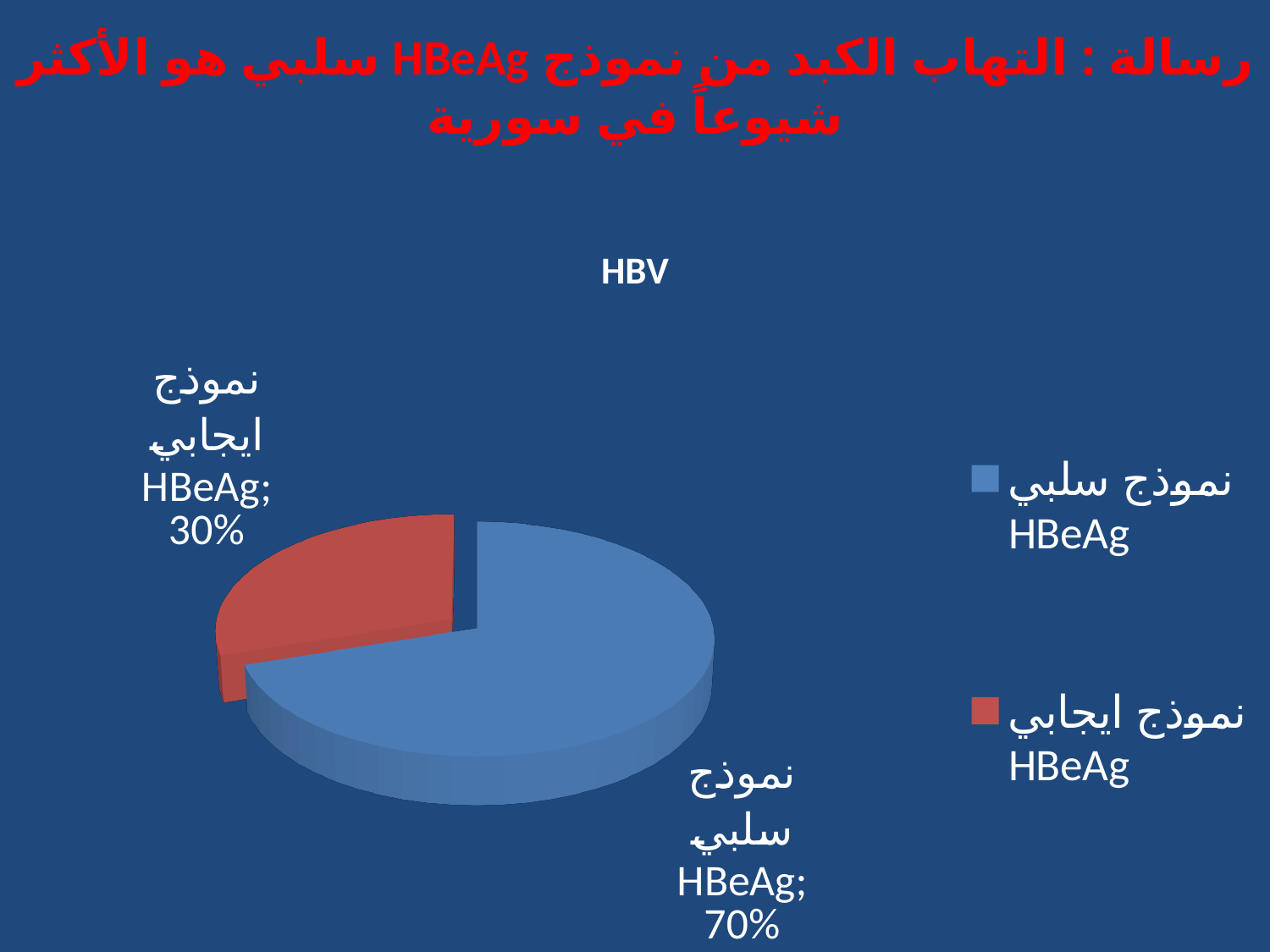
What colour is the slice for نموذج ايجابي HBeAg? red Which slice of the pie is the smallest? نموذج ايجابي HBeAg What is the title of the chart? HBV Which slice of the pie is the largest? نموذج سلبي HBeAg How many entries does the legend list? 2 What share of the pie does the HBeAg negative pattern take? 70% Which is larger, the HBeAg negative slice or the HBeAg positive slice? نموذج سلبي HBeAg What percentage is shown for the HBeAg negative pattern (نموذج سلبي HBeAg)? 70% What kind of chart is shown on the slide? pie chart What percentage is shown for the HBeAg positive pattern (نموذج ايجابي HBeAg)? 30% How many slices does the pie chart have? 2 What is the difference in percentage points between the HBeAg negative and HBeAg positive slices? 40